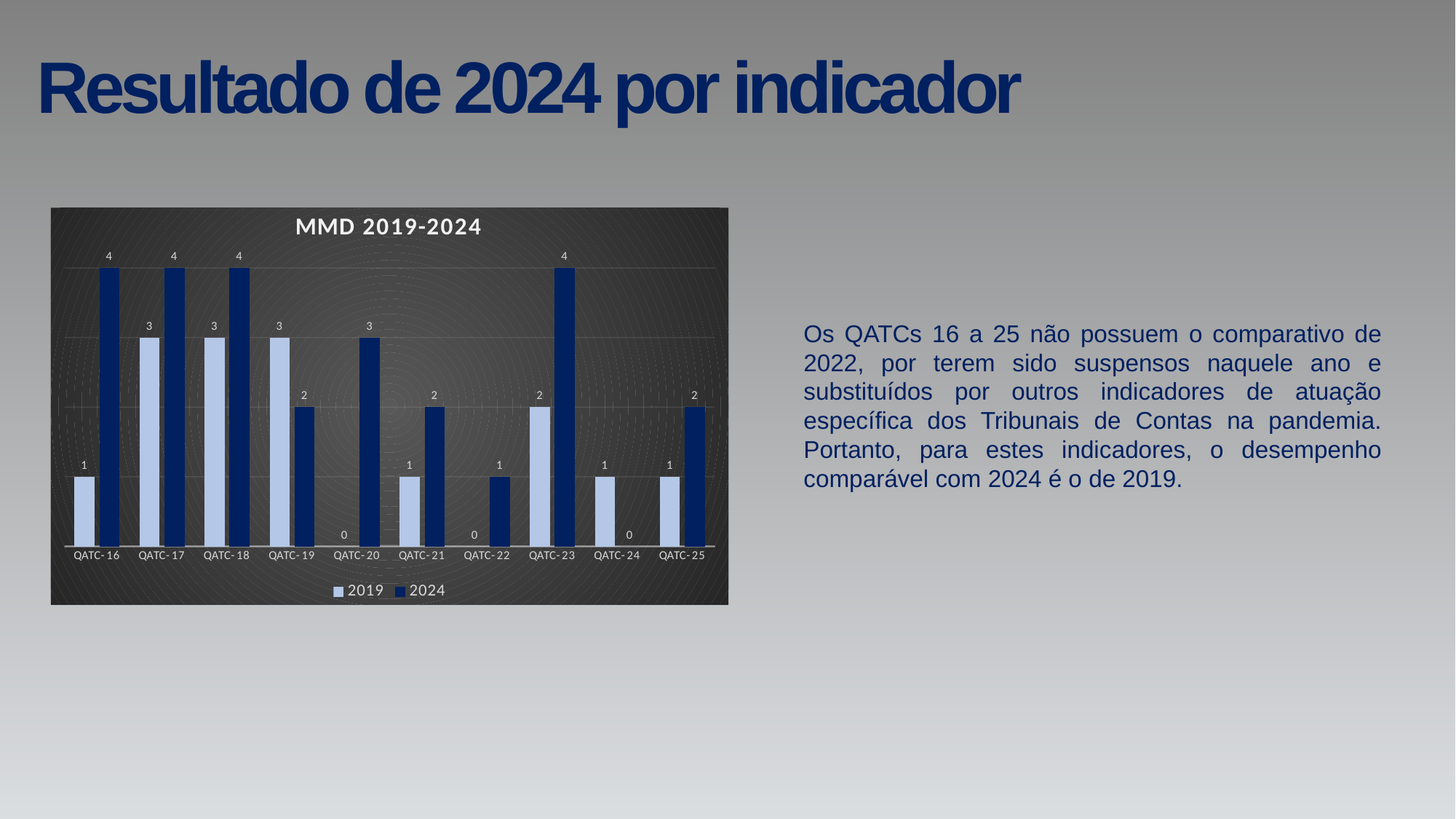
Which category has the lowest 2024 value? QATC-24 What is the 2019 value for QATC-20? 0 How many series does the legend list? 2 What is the difference between the 2024 and 2019 values for QATC-16? 3 For QATC-19, which is larger, the 2019 value or the 2024 value? 2019 What is the 2019 value for QATC-19? 3 What is the difference between the 2024 and 2019 values for QATC-23? 2 How many categories are shown on the x axis? 10 What type of chart is shown? Bar chart What is the 2024 value for QATC-16? 4 What is the 2024 value for QATC-24? 0 For QATC-20, which is larger, the 2019 value or the 2024 value? 2024